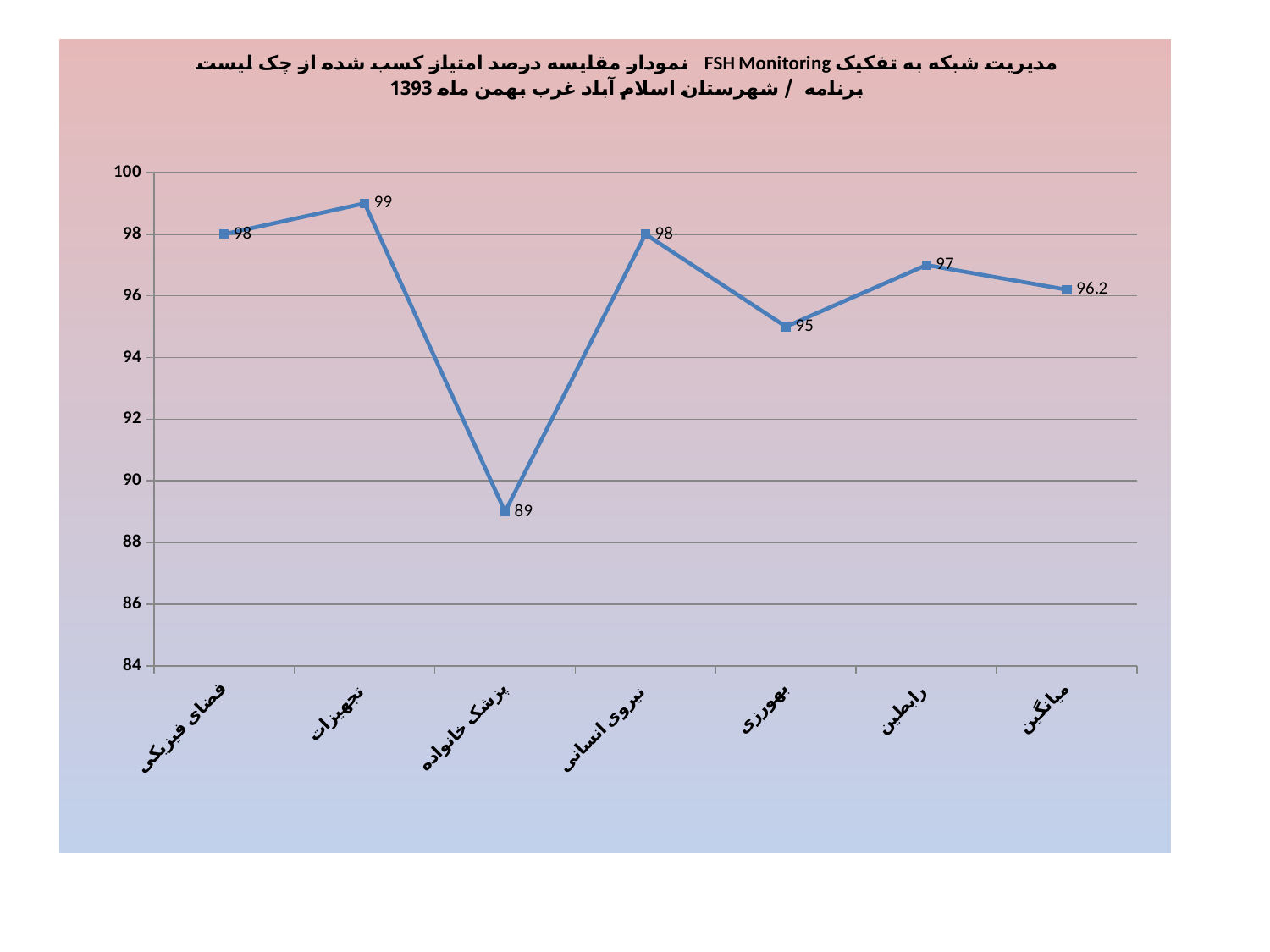
What kind of chart is this? line chart Does the value rise or fall from تجهیزات to پزشک خانواده? fall Is the value for پزشک خانواده greater or less than 90? less Which category has the lowest value? پزشک خانواده What is the value for تجهیزات? 99 What is the difference between the values for تجهیزات and پزشک خانواده? 10 How many categories are shown on the x axis? 7 Which category has the highest value? تجهیزات What is the value for پزشک خانواده? 89 What is the value for بهورزی? 95 What is the value for میانگین? 96.2 Which is larger, the value for رابطین or the value for بهورزی? رابطین